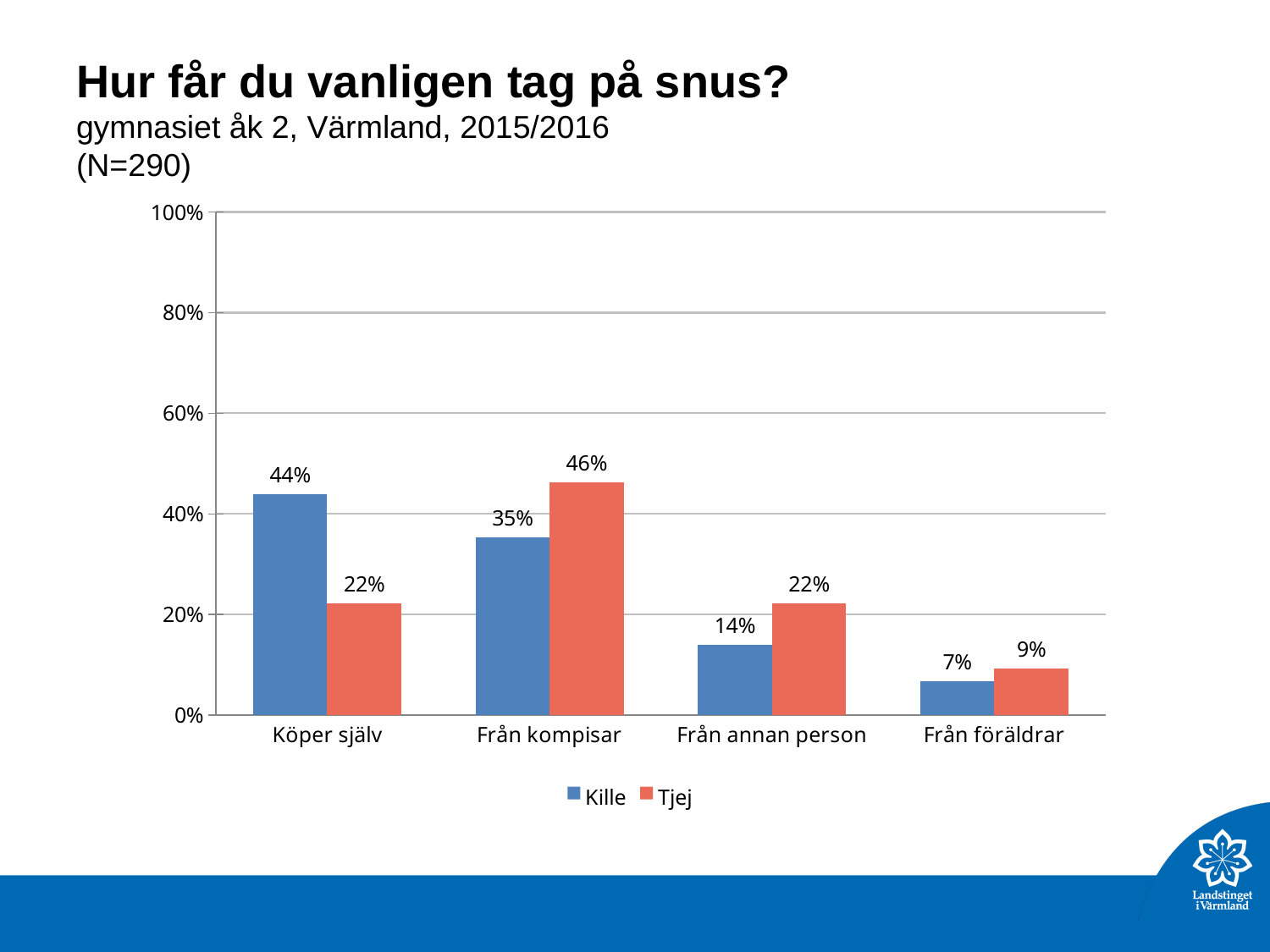
What is the value for Kille in the Köper själv category? 44% What kind of chart is shown on the slide? bar chart What is the value for Tjej in the Från kompisar category? 46% Is the value for Kille in Från kompisar greater or less than 40%? less What is the difference between Kille and Tjej in the Köper själv category? 22% What is the value for Kille in the Från föräldrar category? 7% Which category has the lowest value for Kille? Från föräldrar How many series does the legend list? 2 Which is larger in the Från annan person category, Kille or Tjej? Tjej Which category has the highest value for Tjej? Från kompisar What colour are the Tjej bars? red How many categories are shown on the x axis? 4